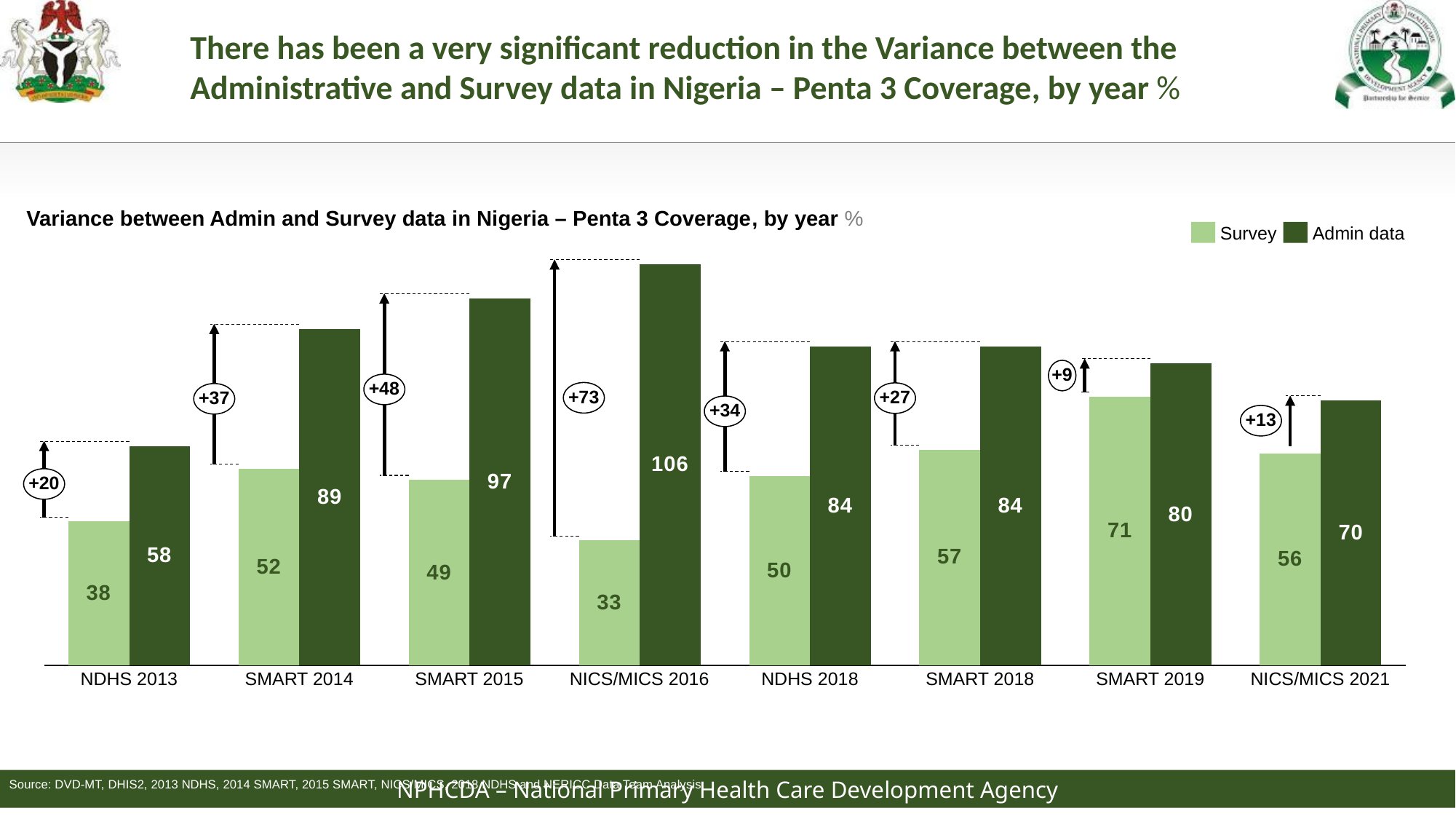
Which is larger for NDHS 2018: the Survey value or the Admin data value? Admin data Which category has the highest Admin data value? NICS/MICS 2016 What is the Admin data value for NICS/MICS 2016? 106 What is the variance annotation shown for SMART 2019? +9 What kind of chart is shown on the slide? Bar chart What is the Survey value for SMART 2019? 71 How many categories are shown on the x axis? 8 What is the Survey value for NDHS 2013? 38 Which category has the lowest Survey value? NICS/MICS 2016 How many series does the legend list? 2 What is the difference between the Admin data and Survey values for SMART 2015? 48 What are the two series named in the legend? Survey and Admin data